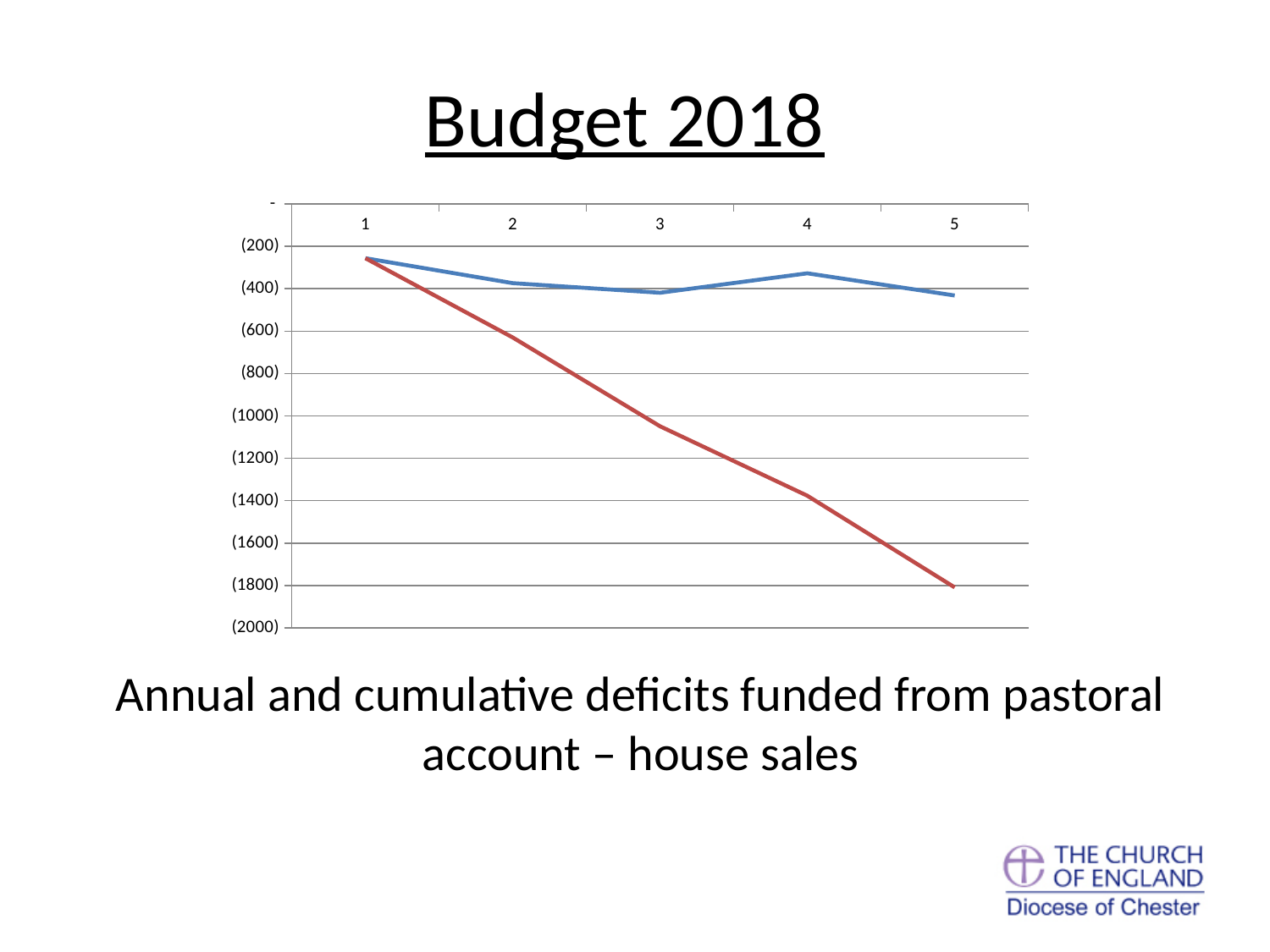
At which x-axis point does the blue line reach its highest value? 1 How many points are labelled along the x axis of the chart? 5 Does the red line rise or fall from point 1 to point 5? fall How many lines are plotted on the chart? 2 What is the title shown above the chart? Budget 2018 At point 5, which line is lower on the chart, the red line or the blue line? red line At point 1, does the blue line lie above or below the (400) gridline? above At which x-axis point does the red line reach its lowest value? 5 At point 3, does the red line lie above or below the (800) gridline? below What kind of chart is shown on the slide? line chart At point 5, does the blue line lie above or below the (600) gridline? above